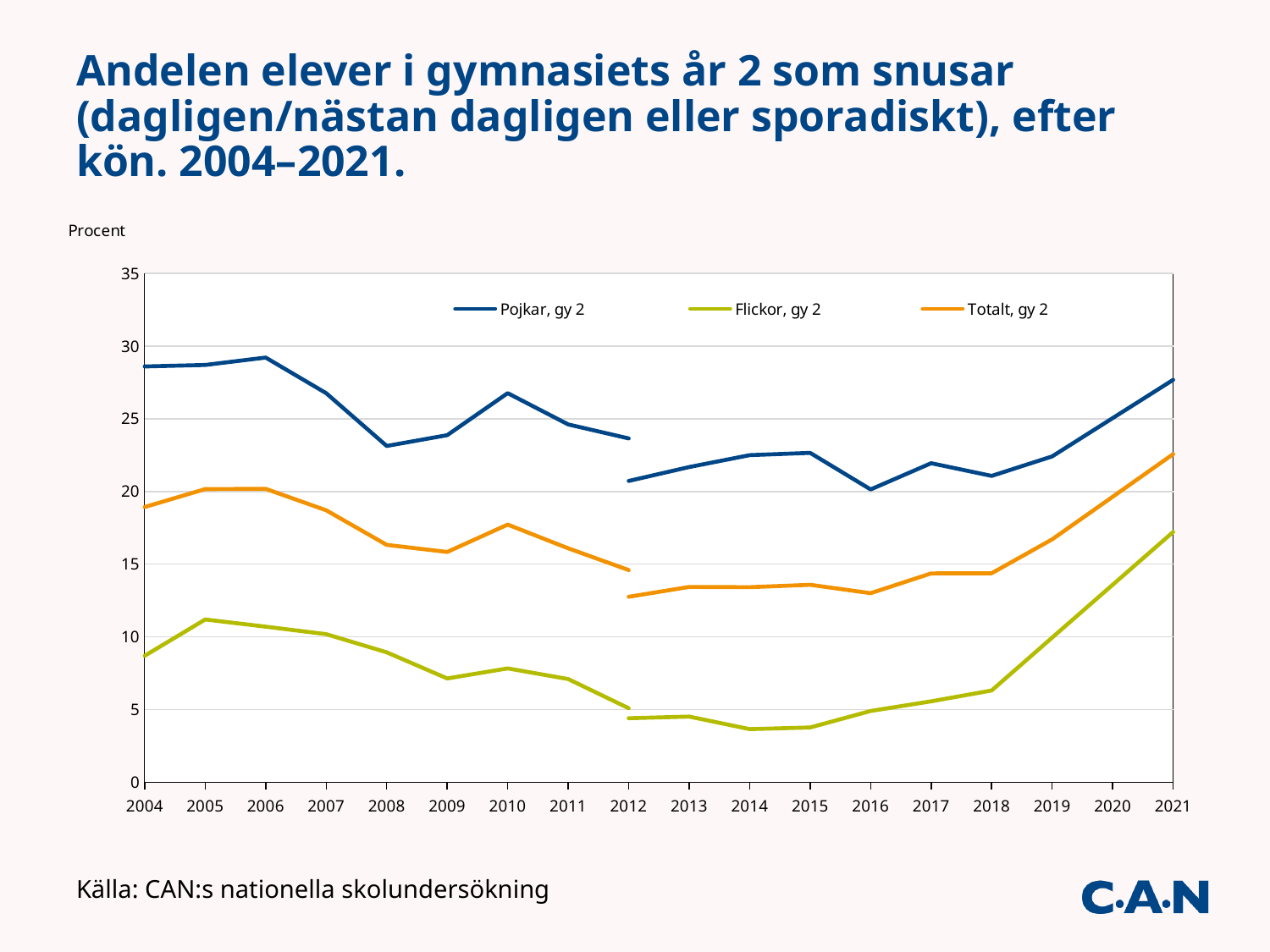
In which year does Totalt, gy 2 reach its highest value? 2021 Is the value for Totalt, gy 2 in 2021 greater or less than 20? greater What kind of chart is shown on the slide? Line chart In 2010, which series has the higher value, Pojkar, gy 2 or Flickor, gy 2? Pojkar, gy 2 What is the label on the vertical axis of the chart? Procent Is the value for Pojkar, gy 2 in 2006 greater or less than 25? greater Is the value for Pojkar, gy 2 in 2008 greater or less than 25? less How many years are shown along the x axis? 18 In which year does Flickor, gy 2 reach its highest value? 2021 Does the Flickor, gy 2 line rise or fall from 2018 to 2021? Rise How many series does the legend list? 3